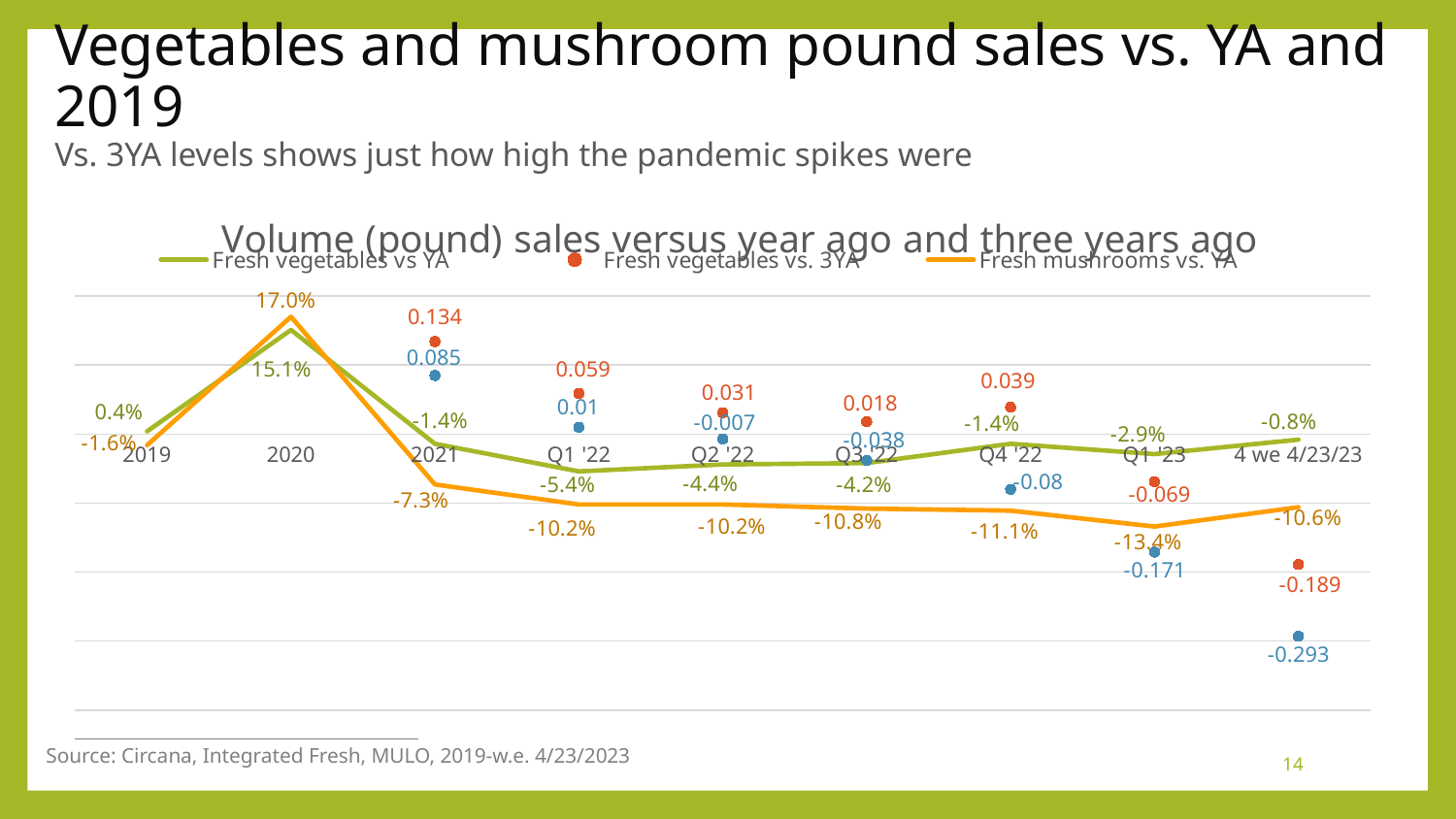
Does the Fresh mushrooms vs. YA series rise or fall from Q1 '22 to Q1 '23? Fall What is the Fresh mushrooms vs. YA value for 2020? 17.0% What is the Fresh vegetables vs YA value for Q1 '22? -5.4% What is the Fresh vegetables vs. 3YA value for 2021? 0.134 What is the difference between the Fresh mushrooms vs. YA value and the Fresh vegetables vs YA value in 2020? 1.9 percentage points In which period is Fresh mushrooms vs. YA at its lowest? Q1 '23 In which period is Fresh vegetables vs YA at its highest? 2020 What is the title of the chart? Volume (pound) sales versus year ago and three years ago What kind of chart is shown on the slide? Line chart How many time periods are shown along the x axis of the chart? 9 In Q4 '22, which is higher: Fresh vegetables vs YA or Fresh mushrooms vs. YA? Fresh vegetables vs YA How many series does the chart legend list? 3